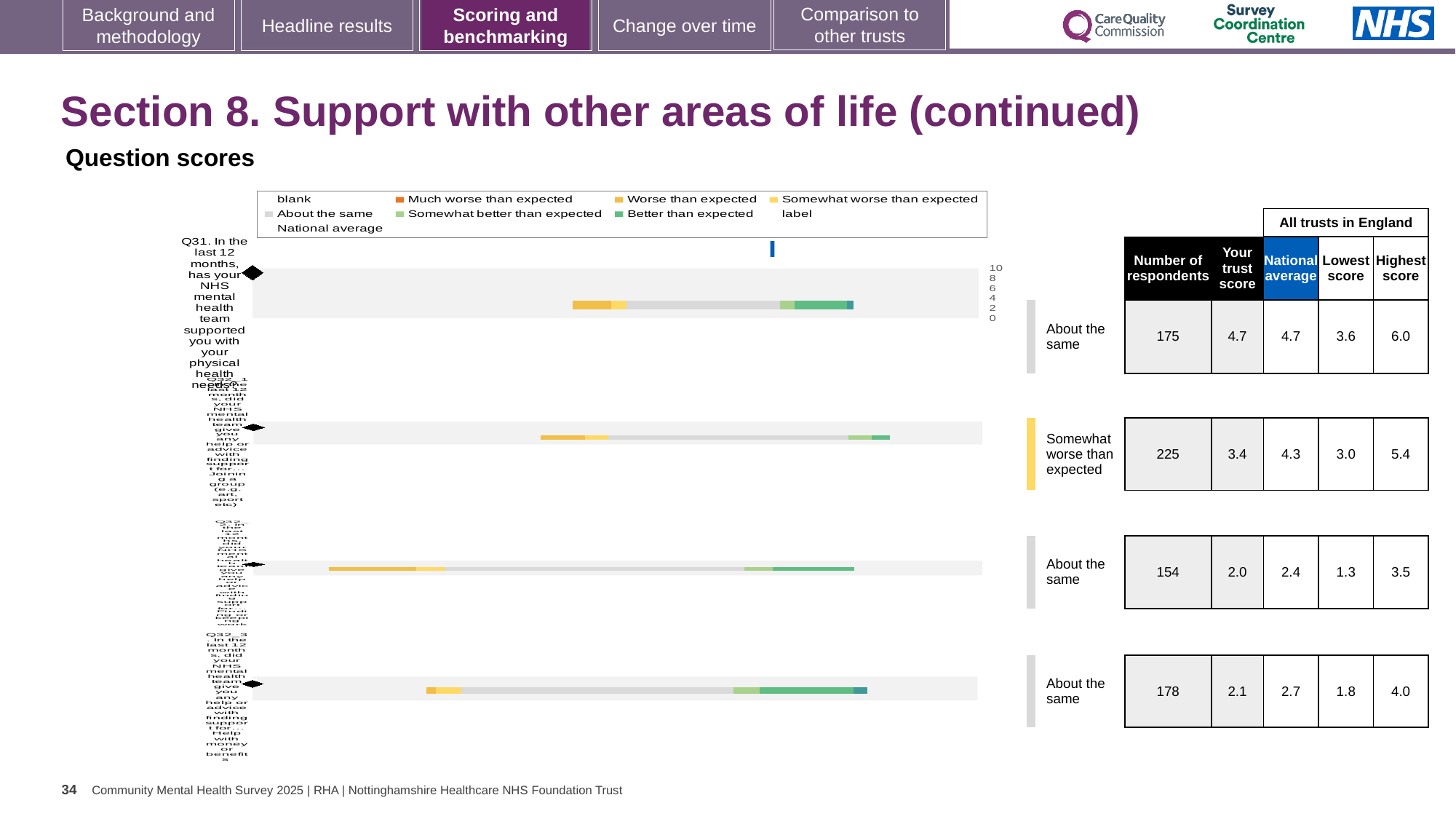
In the table beside the chart, which row has the highest number of respondents? Somewhat worse than expected (225) In the table beside the chart, what is the number of respondents for the Q31 row? 175 In the table beside the chart, what is the trust score for the second row (Somewhat worse than expected)? 3.4 What is the title of the chart section shown above the chart? Question scores How many question bars are plotted in the chart? 4 What is the benchmark category label shown next to the second bar (Q32_1)? Somewhat worse than expected Which legend entry is shown in grey in the chart's legend? About the same In the table beside the chart, what is the national average for the third row? 2.4 In the table beside the chart, what is the difference between the national average and the trust score for the second row? 0.9 What kind of chart is shown on the slide? bar chart In the table beside the chart, what is the highest score for the fourth row? 4.0 What is the benchmark category label shown next to the bar for Q31? About the same